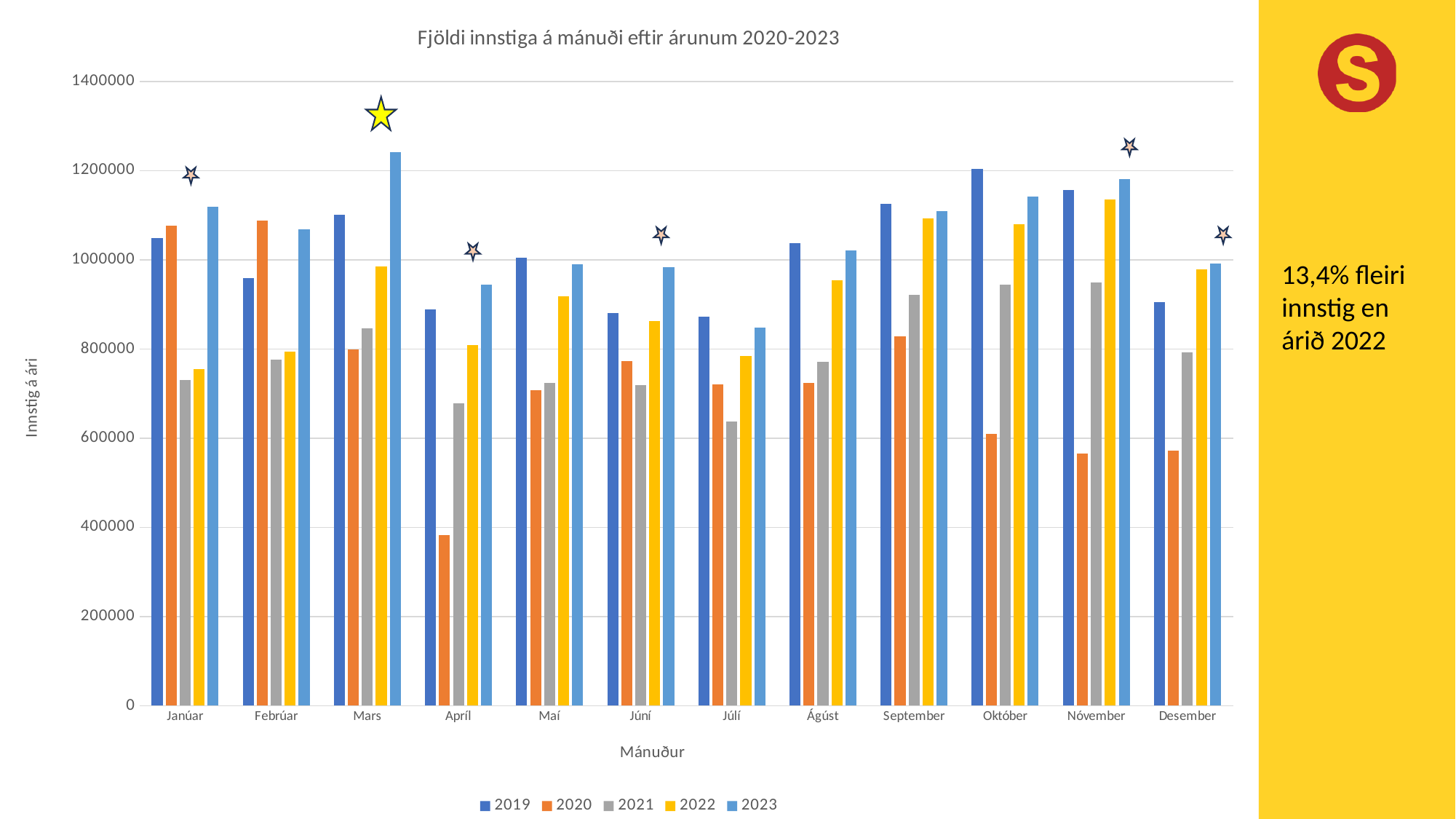
Is the 2023 value for Mars greater or less than 1200000? greater In which month is the 2020 value lowest? Apríl In Október, which is larger: the 2019 value or the 2023 value? 2019 What is the title of the chart? Fjöldi innstiga á mánuði eftir árunum 2020-2023 What kind of chart is shown on the slide? Bar chart In which month is the 2019 value highest? Október Is the 2020 value for Apríl greater or less than 400000? less How many series does the legend list? 5 In which month is the 2023 value lowest? Júlí Is the 2021 value for Júlí greater or less than 800000? less In which month is the 2023 value highest? Mars How many months are shown on the x axis? 12